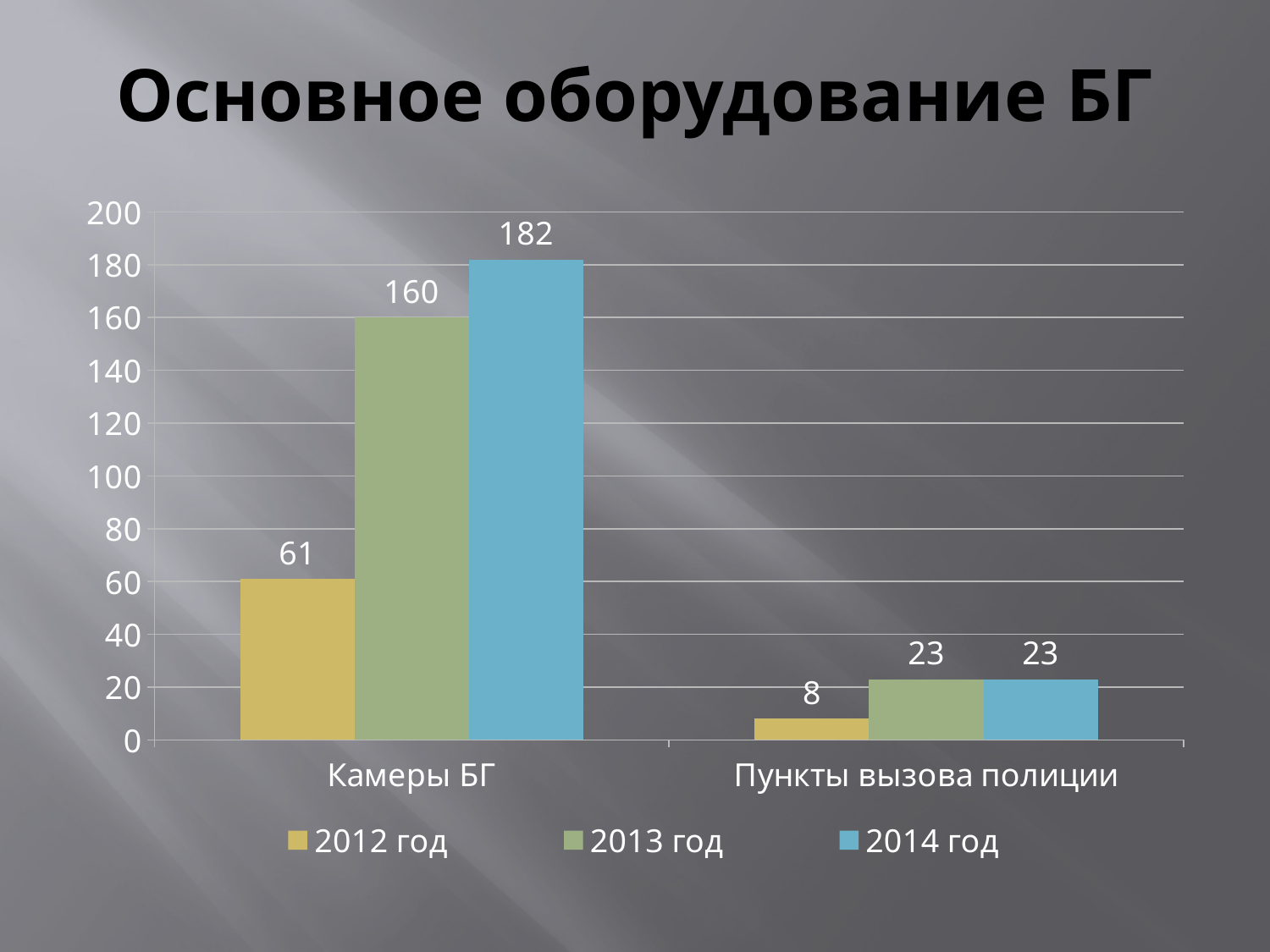
What kind of chart is shown on the slide? Bar chart What is the value for Пункты вызова полиции in 2013 год? 23 What is the difference between the 2014 год and 2013 год values for Камеры БГ? 22 What is the value for Камеры БГ in 2012 год? 61 What is the value for Камеры БГ in 2014 год? 182 What is the difference between the 2013 год and 2012 год values for Пункты вызова полиции? 15 How many categories are shown on the x axis? 2 What is the value for Пункты вызова полиции in 2012 год? 8 How many series does the legend list? 3 Which year has the highest value for Камеры БГ? 2014 год Which year has the lowest value for Пункты вызова полиции? 2012 год Which is larger: Камеры БГ in 2013 год or Камеры БГ in 2012 год? Камеры БГ in 2013 год